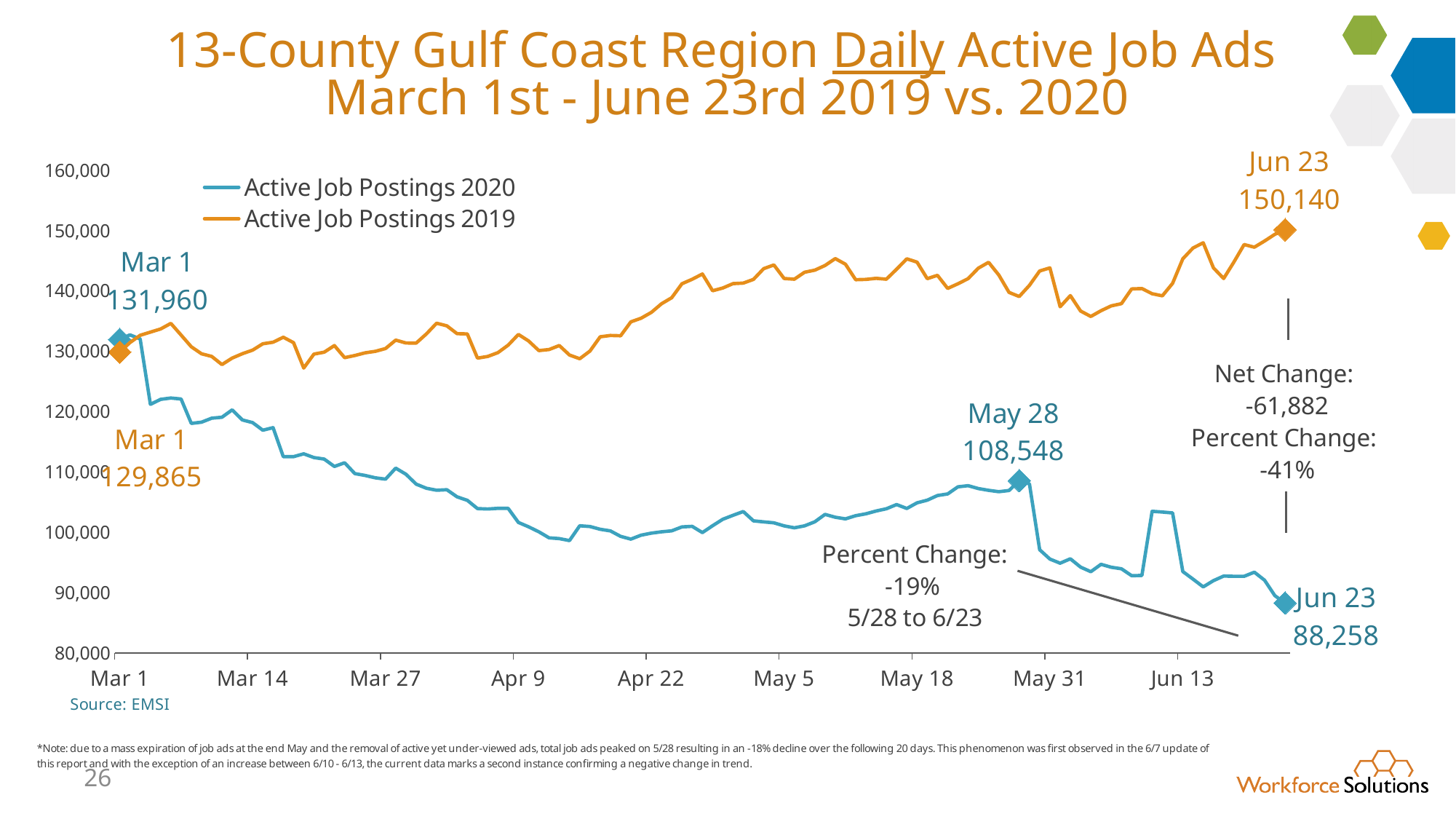
What is the value of Active Job Postings 2020 on Mar 1? 131,960 How much did Active Job Postings 2020 fall from May 28 to Jun 23? 20,290 What is the difference between the 2019 and 2020 values on Jun 23? 61,882 What is the value of Active Job Postings 2019 on Mar 1? 129,865 Does the Active Job Postings 2020 series rise or fall overall from Mar 1 to Jun 23? fall What type of chart is shown on the slide? line chart What is the value of Active Job Postings 2020 on Jun 23? 88,258 How many series does the legend list? 2 What is the value of Active Job Postings 2020 on May 28? 108,548 What is the value of Active Job Postings 2019 on Jun 23? 150,140 On Mar 1, which series has the larger value, Active Job Postings 2020 or Active Job Postings 2019? Active Job Postings 2020